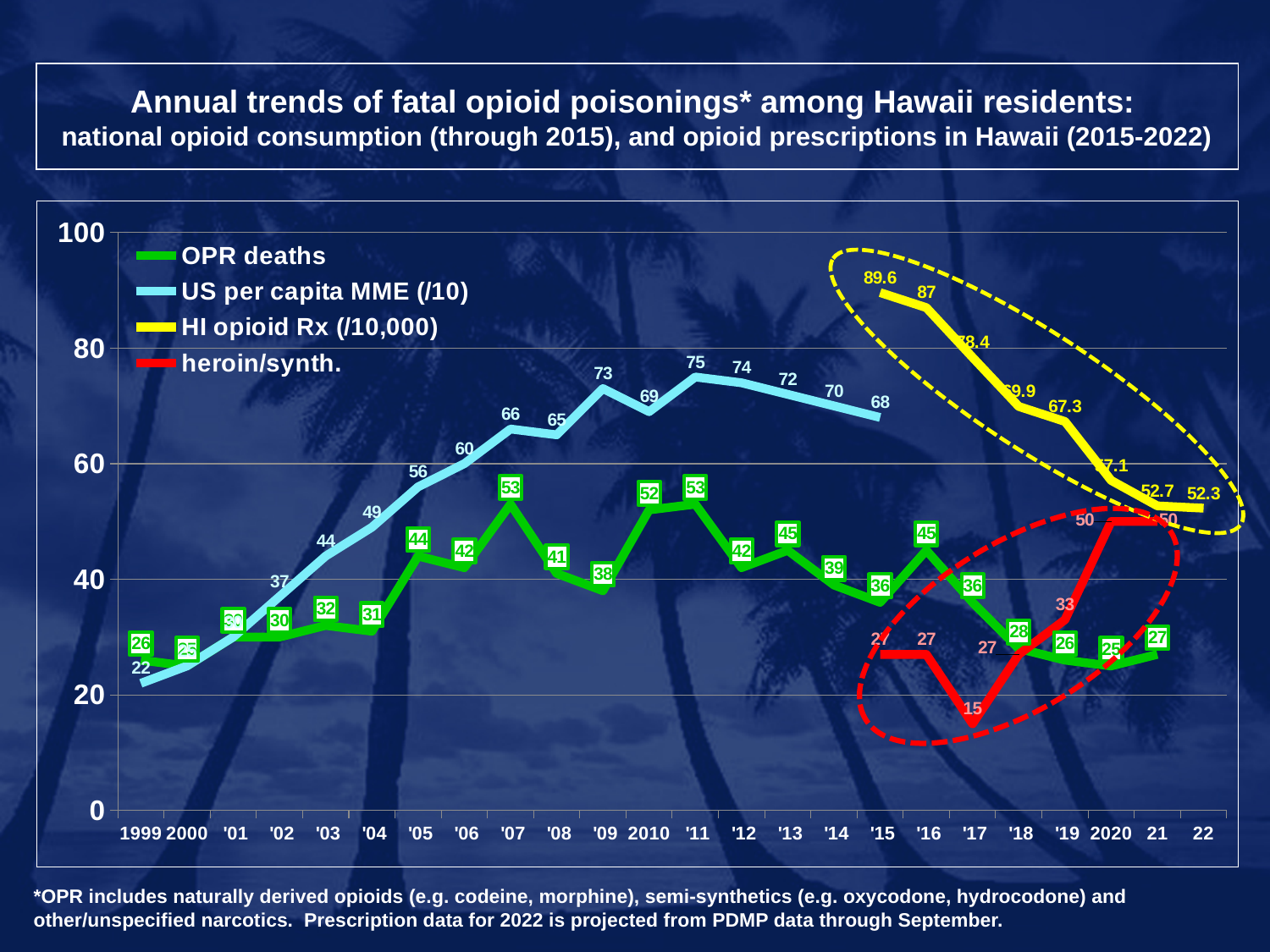
In which year is heroin/synth. lowest? '17 What is the value of US per capita MME (/10) in '11? 75 Which is larger in '16: OPR deaths or heroin/synth.? OPR deaths What kind of chart is shown on the slide? line chart How many series does the legend list? 4 In which year is US per capita MME (/10) highest? '11 What is the difference between HI opioid Rx (/10,000) in '15 and in 22? 37.3 What is the value of OPR deaths in '07? 53 What is the value of heroin/synth. in '17? 15 Does HI opioid Rx (/10,000) rise or fall from '15 to 22? fall What colour is the heroin/synth. line? red What is the value of HI opioid Rx (/10,000) in '15? 89.6